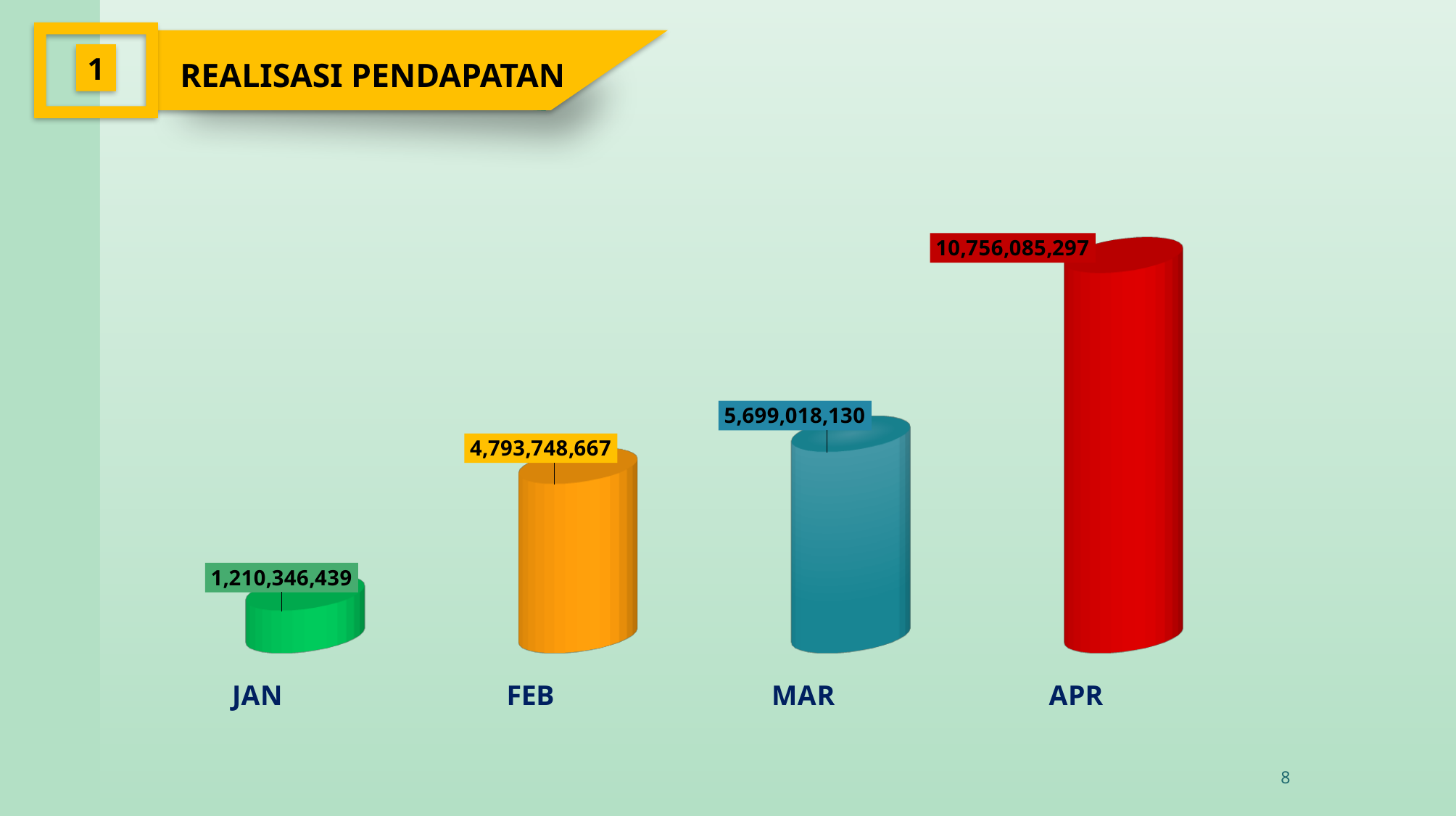
What is the value for APR? 10,756,085,297 Which month has the lowest value? JAN What is the value for FEB? 4,793,748,667 Which is larger, the value for MAR or the value for FEB? MAR What is the value for MAR? 5,699,018,130 What is the difference between the values for APR and MAR? 5,057,067,167 What kind of chart is shown on the slide? Bar chart What is the difference between the values for FEB and JAN? 3,583,402,228 Do the values rise or fall from JAN to APR? Rise How many months are shown in the chart? 4 Which month has the highest value? APR What is the value for JAN? 1,210,346,439